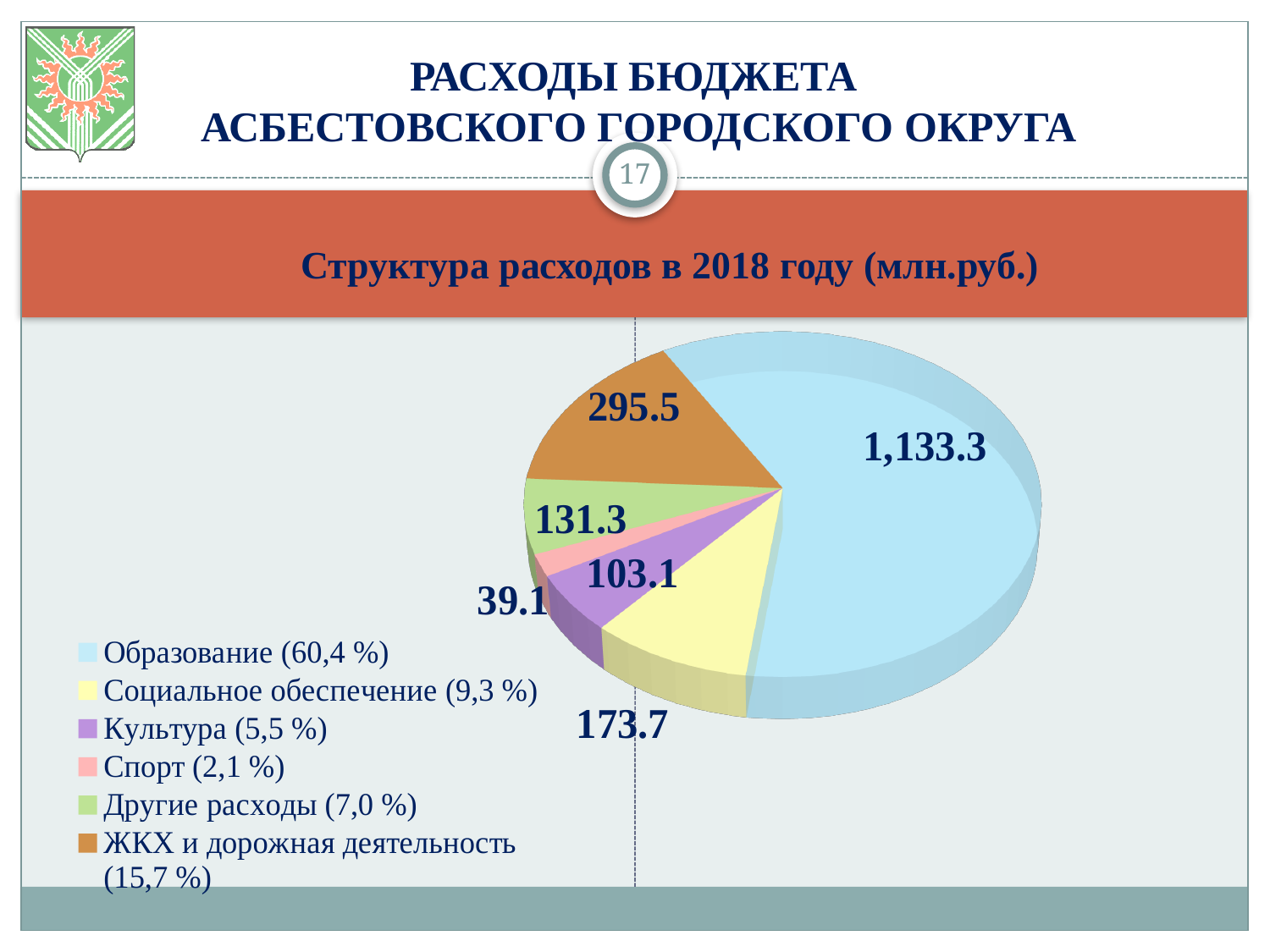
What is the value for Образование in the pie chart? 1,133.3 Which category has the smallest slice of the pie? Спорт What is the value for Социальное обеспечение? 173.7 What is the value for Спорт? 39.1 What share of the pie does Социальное обеспечение represent? 9,3 % Which category has the largest slice of the pie? Образование What kind of chart is shown on the slide? Pie chart How many categories does the pie chart show? 6 What is the difference between the values for ЖКХ и дорожная деятельность and Социальное обеспечение? 121.8 Which is larger, the value for Культура or the value for Другие расходы? Другие расходы What is the value for ЖКХ и дорожная деятельность? 295.5 What is the difference between the values for Другие расходы and Культура? 28.2